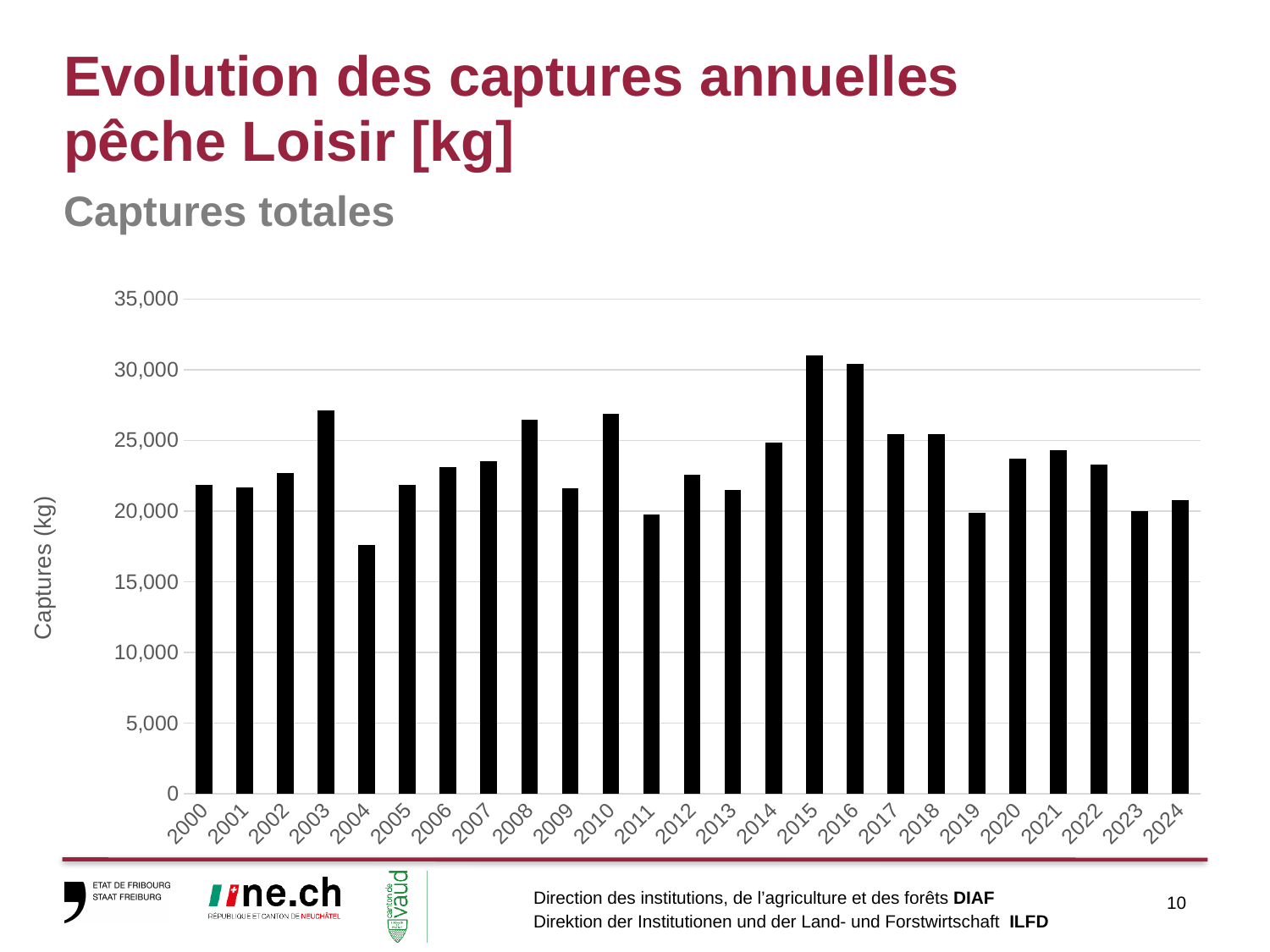
Is the value for 2003 greater or less than 25,000? greater What is the label on the vertical axis of the chart? Captures (kg) What kind of chart is shown on the slide? bar chart Which year has the highest total catch in the chart? 2015 What colour are the bars in the chart? black Which year has the larger total catch, 2003 or 2004? 2003 Which year has the larger total catch, 2010 or 2012? 2010 Which year has the lowest total catch in the chart? 2004 Is the value for 2015 greater or less than 30,000? greater Is the value for 2004 greater or less than 20,000? less How many years (bars) are plotted in the chart? 25